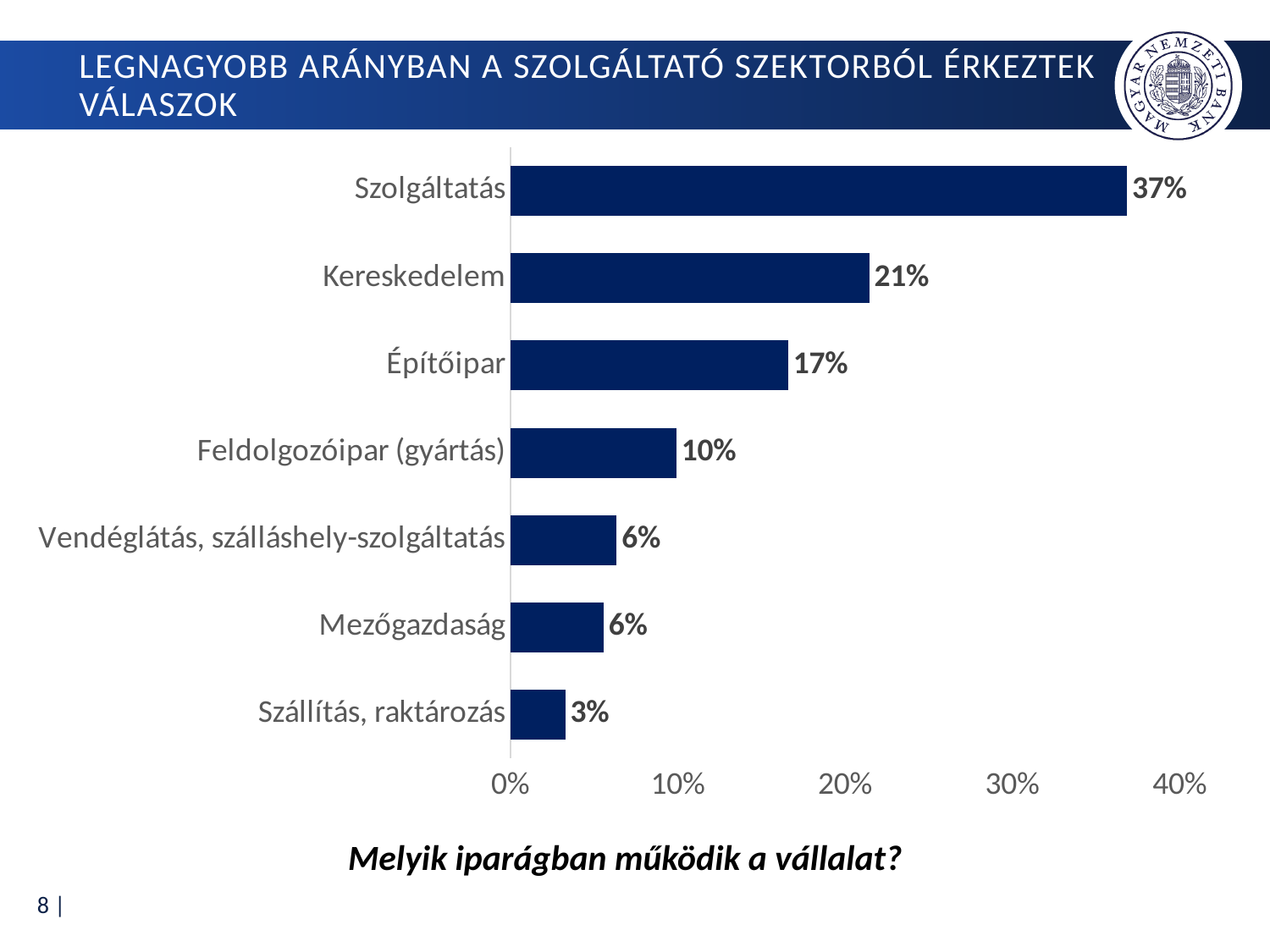
What is the difference between the values for Építőipar and Feldolgozóipar (gyártás)? 7% What is the difference between the values for Szolgáltatás and Kereskedelem? 16% How many categories are shown in the chart? 7 What kind of chart is shown on the slide? Bar chart Which is larger, the value for Kereskedelem or the value for Építőipar? Kereskedelem Which category has the highest value? Szolgáltatás What is the value for Szállítás, raktározás? 3% What is the value for Feldolgozóipar (gyártás)? 10% What is the value for Kereskedelem? 21% Which category has the lowest value? Szállítás, raktározás What is the value for Szolgáltatás? 37% What question is written below the chart? Melyik iparágban működik a vállalat?